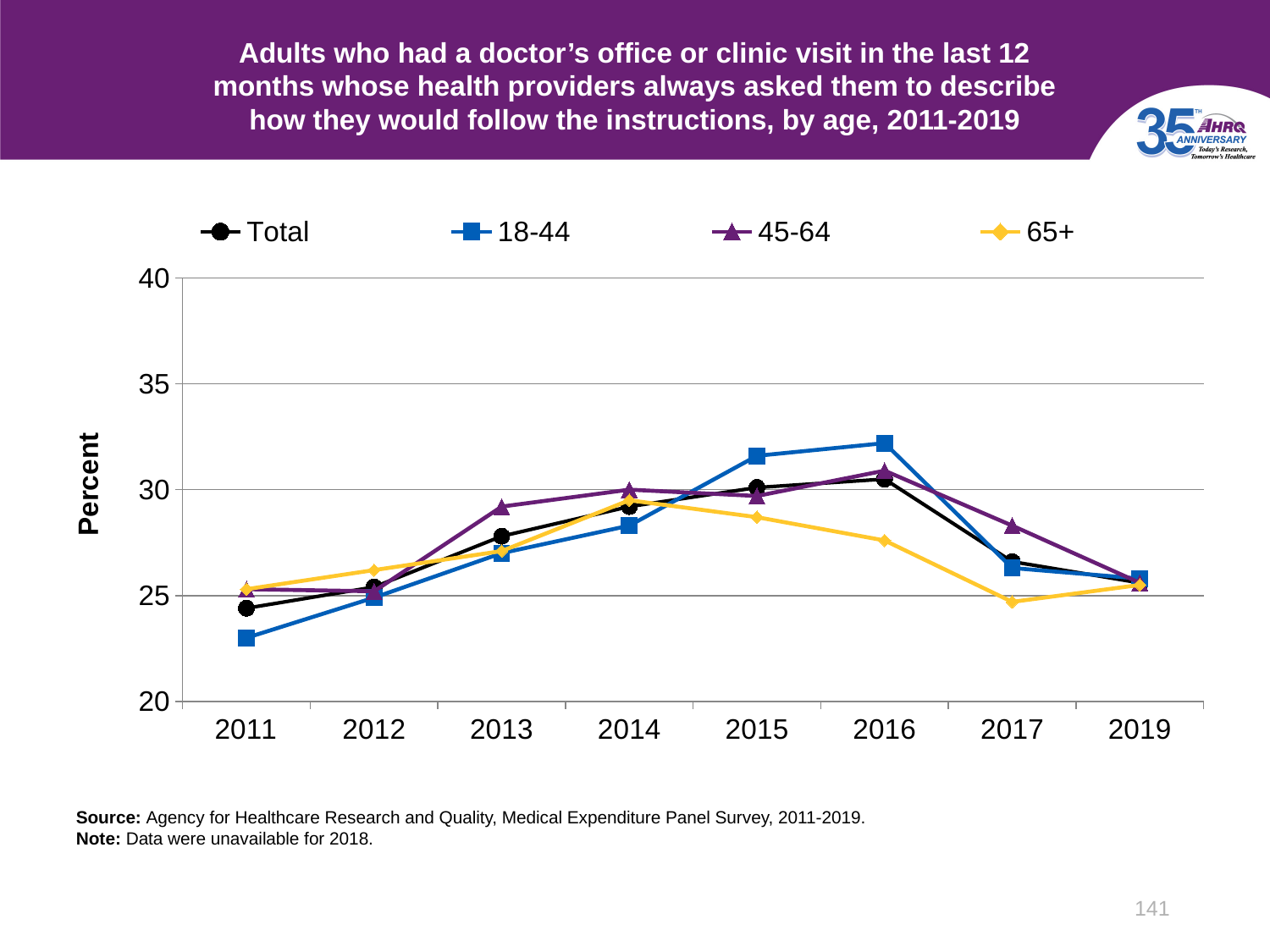
Is the value for 65+ in 2016 greater or less than 30? less Does the 18-44 series rise or fall from 2011 to 2016? Rise Is the value for 18-44 in 2016 greater or less than 30? greater In 2017, which series has the larger value, 45-64 or 18-44? 45-64 In 2016, which series has the larger value, 18-44 or 65+? 18-44 In which year is the value for the Total series lowest? 2011 What kind of chart is shown on the slide? Line chart In which year is the value for the 18-44 series highest? 2016 In which year is the value for the 18-44 series lowest? 2011 Is the value for 18-44 in 2011 greater or less than 25? less How many series does the legend list? 4 How many years are plotted along the x axis? 8